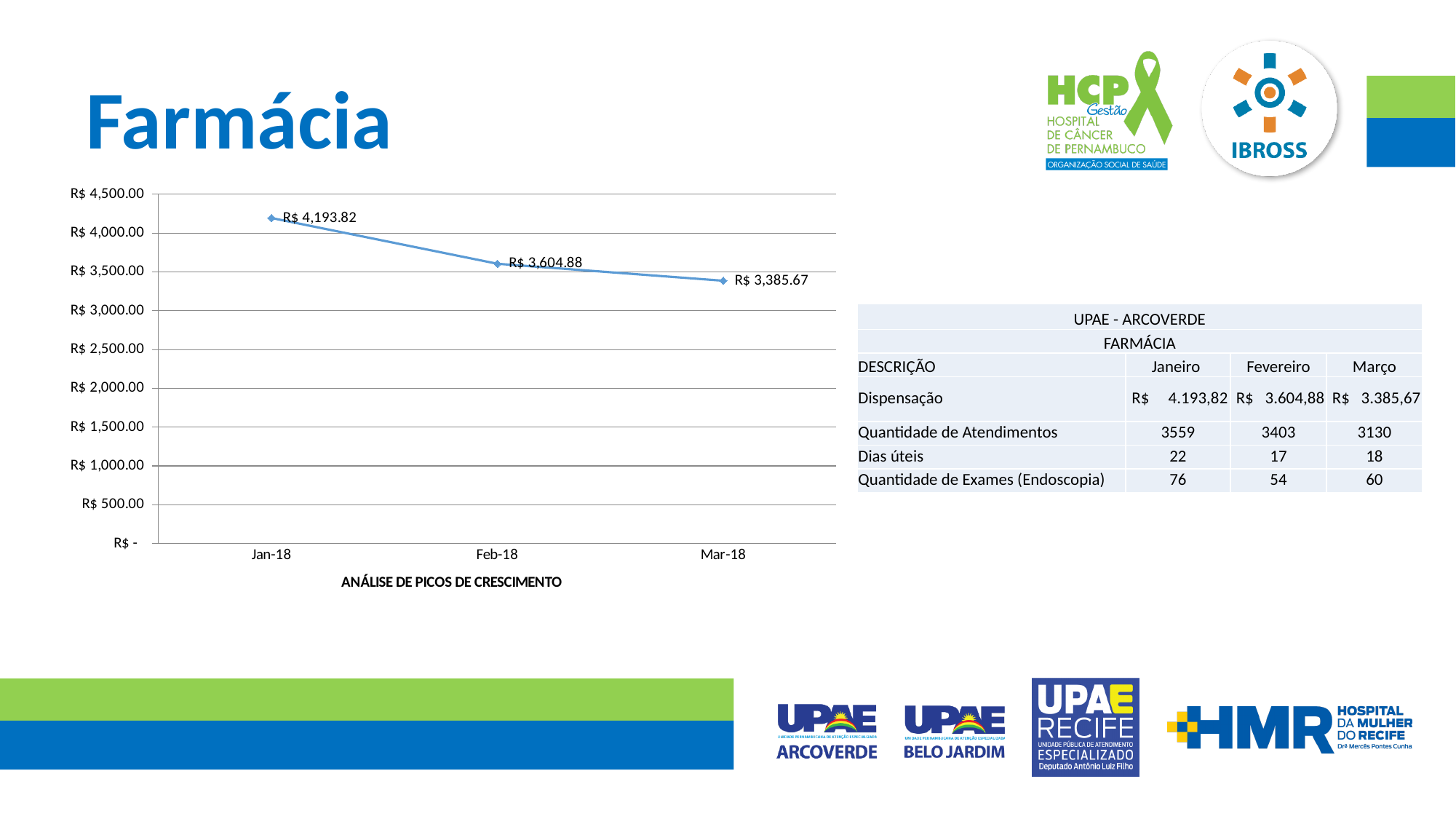
Which month has the lowest value on the chart? Mar-18 What is the difference between the Jan-18 and Feb-18 values? R$ 588.94 How many data points are plotted on the chart? 3 What is the value plotted for Feb-18? R$ 3,604.88 What is the value plotted for Mar-18? R$ 3,385.67 What is the value plotted for Jan-18? R$ 4,193.82 What type of chart is shown on the slide? line chart What is the difference between the Feb-18 and Mar-18 values? R$ 219.21 Do the values rise or fall from Jan-18 to Mar-18? fall Is the value for Jan-18 greater or less than R$ 4,000.00? greater Which is larger, the value for Feb-18 or the value for Mar-18? Feb-18 Which month has the highest value on the chart? Jan-18